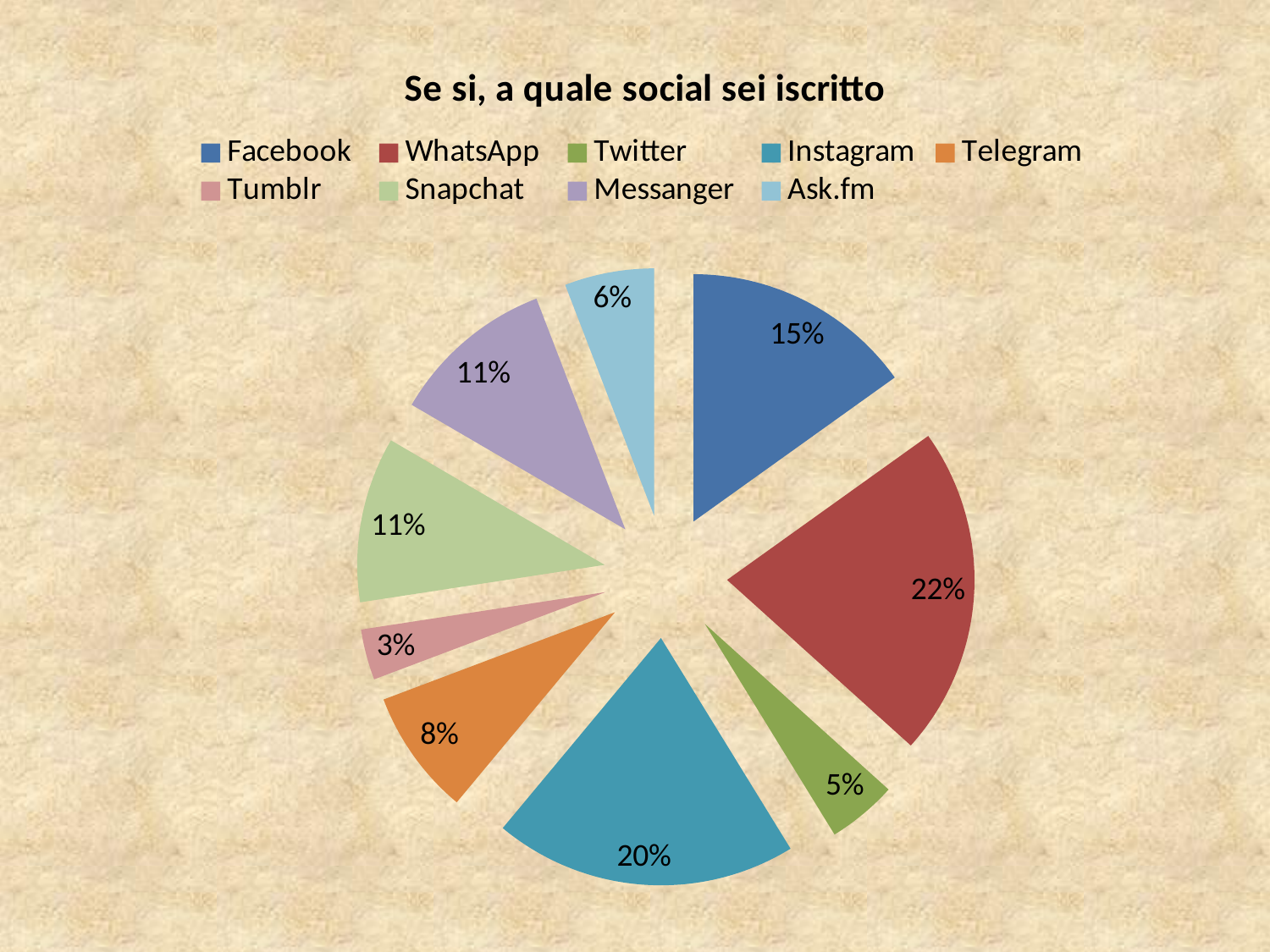
What is the value shown for Twitter? 5% What is the value shown for Facebook? 15% What is the title of the chart? Se si, a quale social sei iscritto What type of chart is shown on the slide? pie chart Which social network has the smallest slice? Tumblr What share of the pie does WhatsApp have? 22% What share of the pie does Instagram have? 20% How many categories does the legend list? 9 Which social network has the largest slice? WhatsApp What is the value shown for Tumblr? 3% What is the difference between the WhatsApp and Facebook shares? 7% Which is larger, the Telegram slice or the Ask.fm slice? Telegram